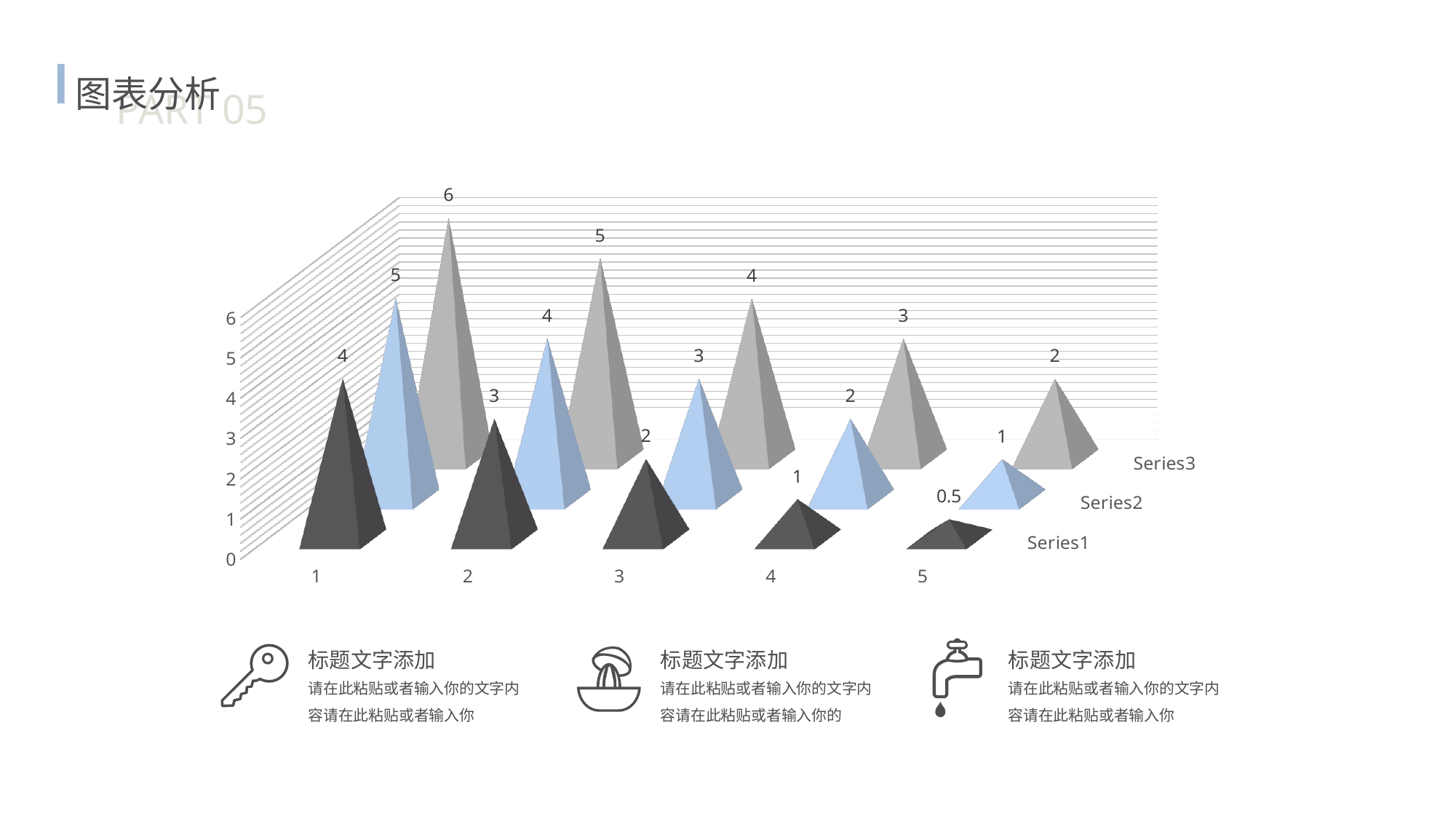
What is the value of Series3 for category 1? 6 How many series does the chart show? 3 What kind of chart is shown on the slide? bar chart How many categories are shown on the x axis? 5 Which category has the highest value for Series3? 1 What is the value of Series1 for category 2? 3 What is the difference between Series3 and Series1 for category 1? 2 What is the value of Series2 for category 3? 3 Which category has the lowest value for Series1? 5 What is the value of Series1 for category 5? 0.5 Do the values of Series2 rise or fall from category 1 to category 5? fall Which is larger for category 4: Series2 or Series1? Series2